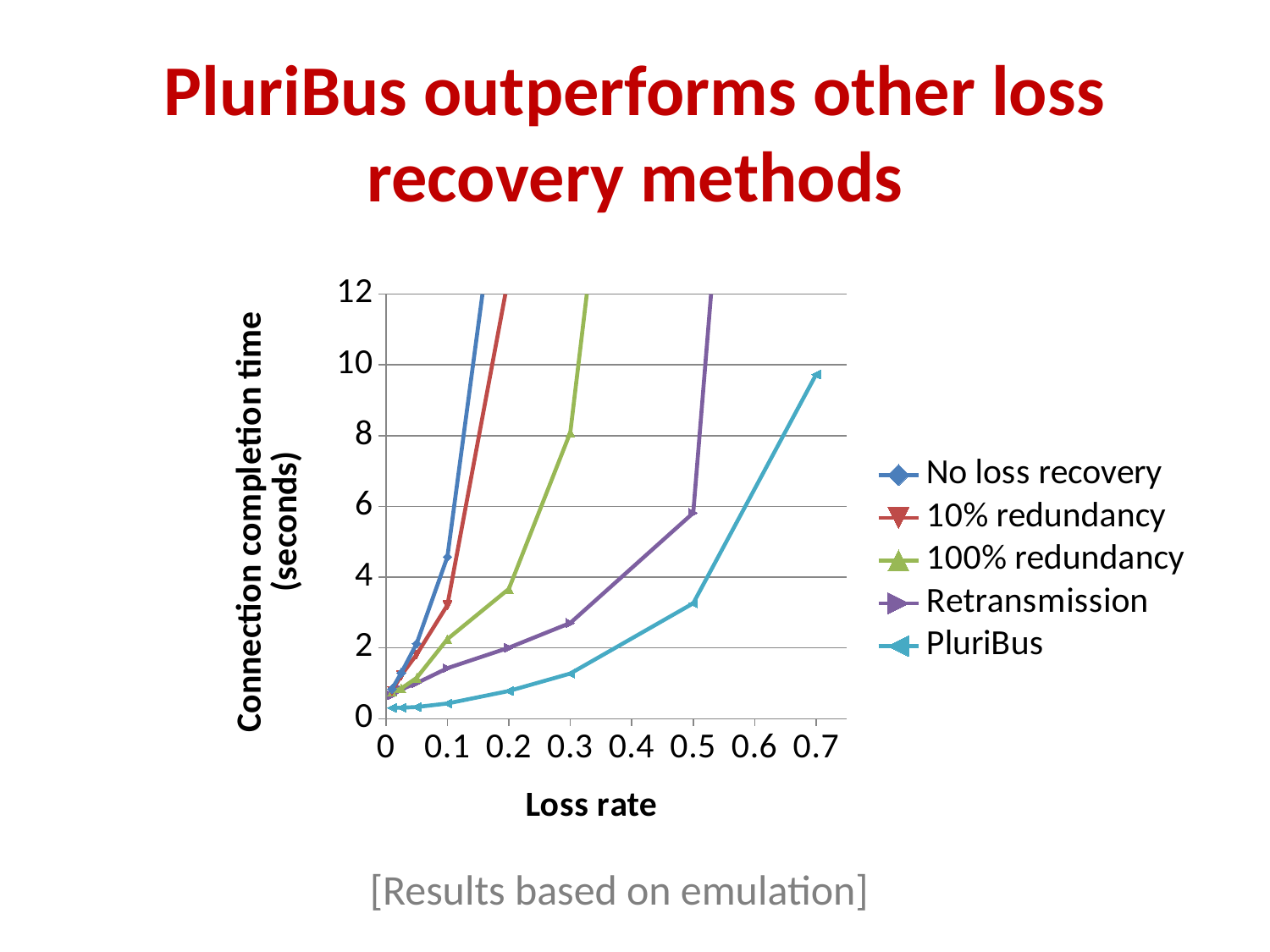
How many series does the legend list? 5 Is the connection completion time for PluriBus at a loss rate of 0.7 greater or less than 8? greater Is the connection completion time for Retransmission at a loss rate of 0.5 greater or less than 4? greater What kind of chart is shown on the slide? line chart At a loss rate of 0.5, which has the higher connection completion time, Retransmission or PluriBus? Retransmission What is the label of the y axis? Connection completion time (seconds) Does the connection completion time for PluriBus rise or fall as the loss rate increases? rise Which series has the lowest connection completion time at a loss rate of 0.3? PluriBus What is the label of the x axis? Loss rate Is the connection completion time for PluriBus at a loss rate of 0.5 greater or less than 4? less